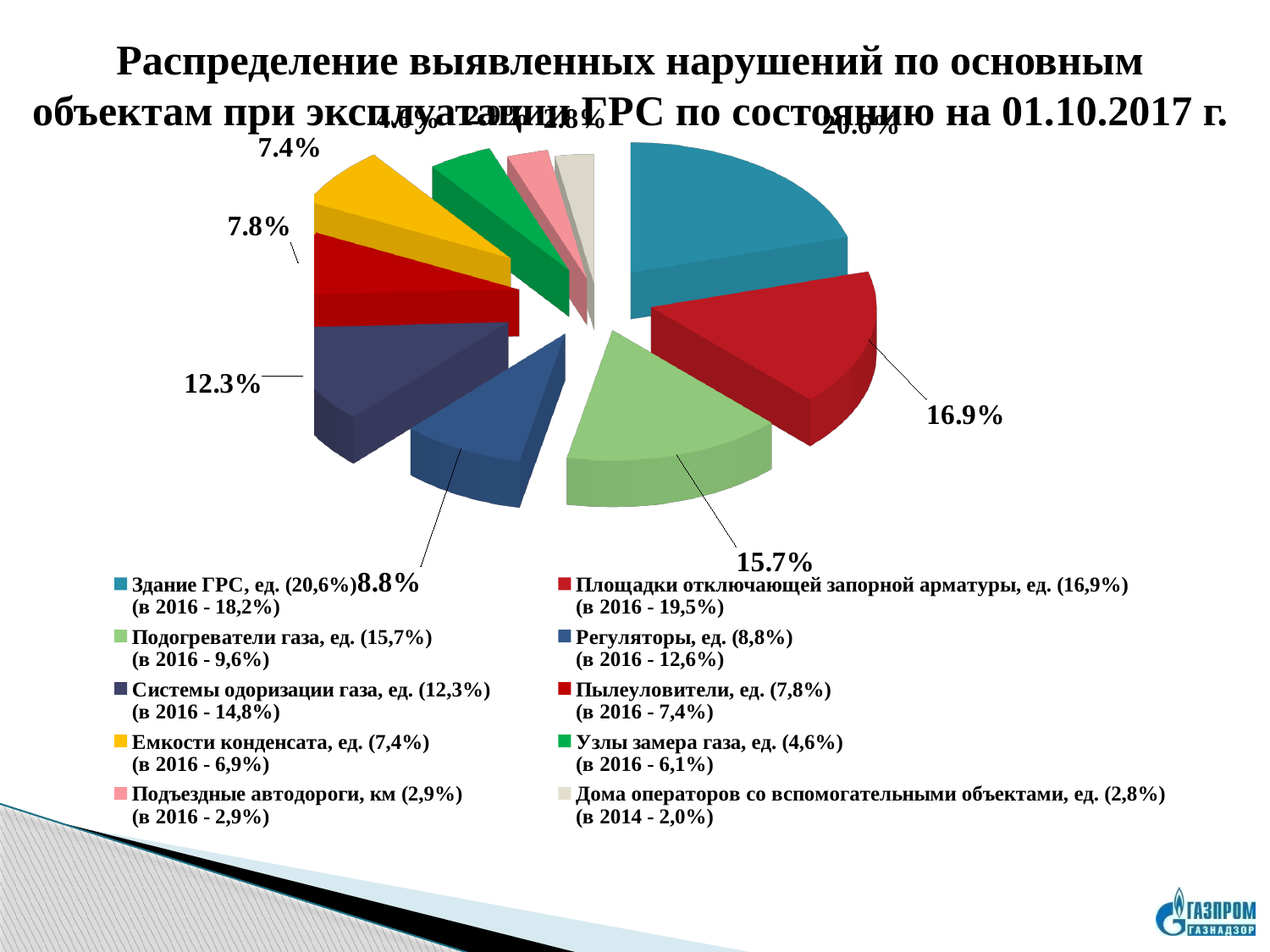
Which category has the smallest share of the pie? Дома операторов со вспомогательными объектами What is the share for Узлы замера газа according to the legend? 4,6% What kind of chart is shown on the slide? pie chart Which has the larger share: Емкости конденсата or Пылеуловители? Пылеуловители What is the difference in percentage points between Площадки отключающей запорной арматуры (16.9%) and Пылеуловители (7.8%)? 9.1 What is the share for Регуляторы? 8.8% According to the legend, what was the share of Здание ГРС in 2016? 18,2% What is the share for Подогреватели газа? 15.7% Which category has the largest share of the pie? Здание ГРС How many categories (slices) does the pie chart have? 10 What is the share for Системы одоризации газа? 12.3% What colour is the slice for Подогреватели газа? light green